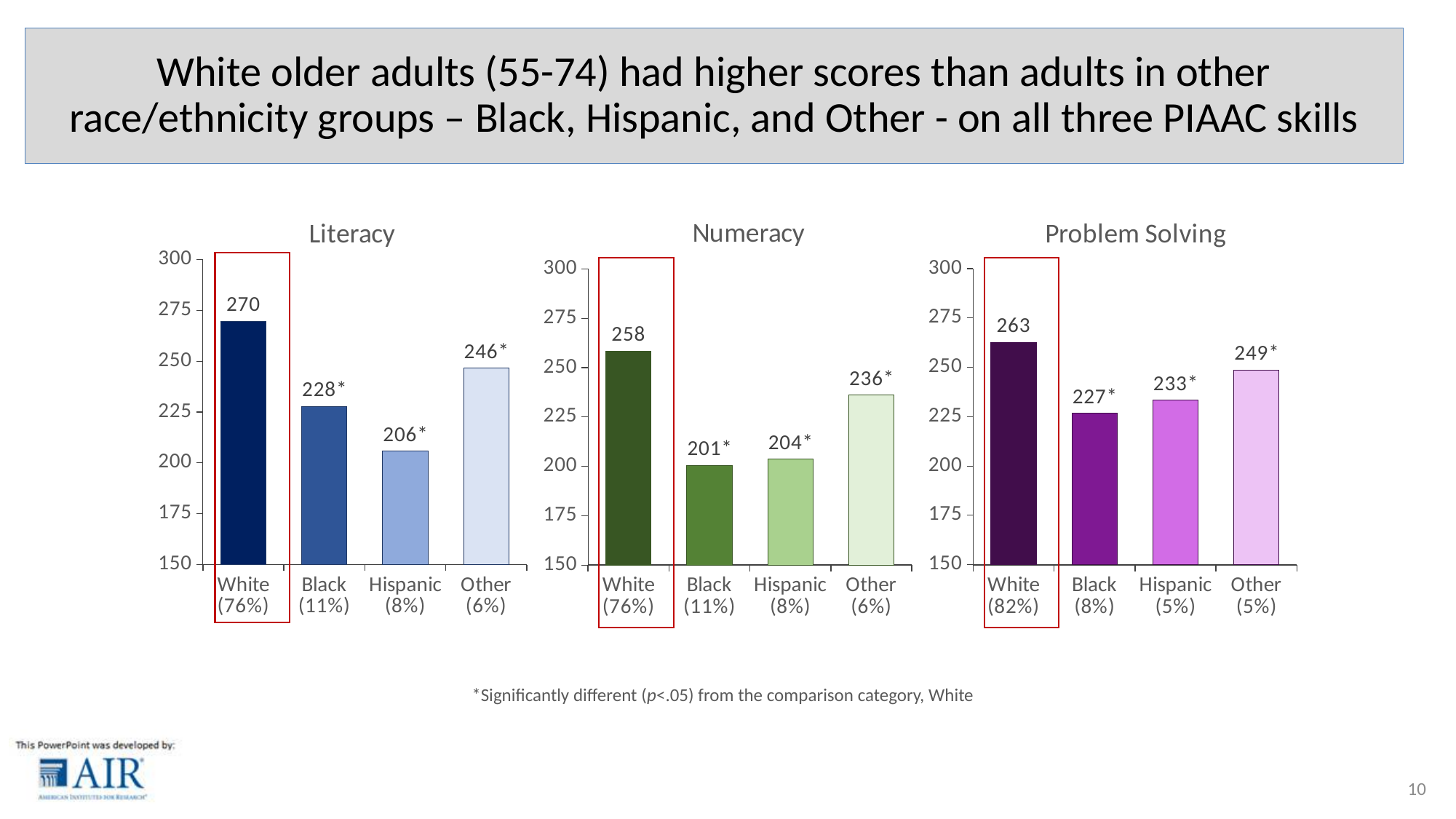
In the Problem Solving chart, what is the score for Other (5%)? 249 In the Numeracy chart, what is the difference between the Other and Hispanic scores? 32 In the Numeracy chart, what is the score for Hispanic (8%)? 204 How many race/ethnicity groups are shown in the Numeracy chart? 4 In the Literacy chart, what is the score for White (76%)? 270 In the Problem Solving chart, which group has the lowest score? Black (8%) In the Problem Solving chart, which is larger, the Hispanic score or the Black score? Hispanic What type of chart is the Literacy chart? Bar chart In the Literacy chart, which group has the lowest score? Hispanic (8%) In the Numeracy chart, which group has the highest score? White (76%) In the Literacy chart, what is the difference between the White and Black scores? 42 What is the title of the rightmost chart on the slide? Problem Solving